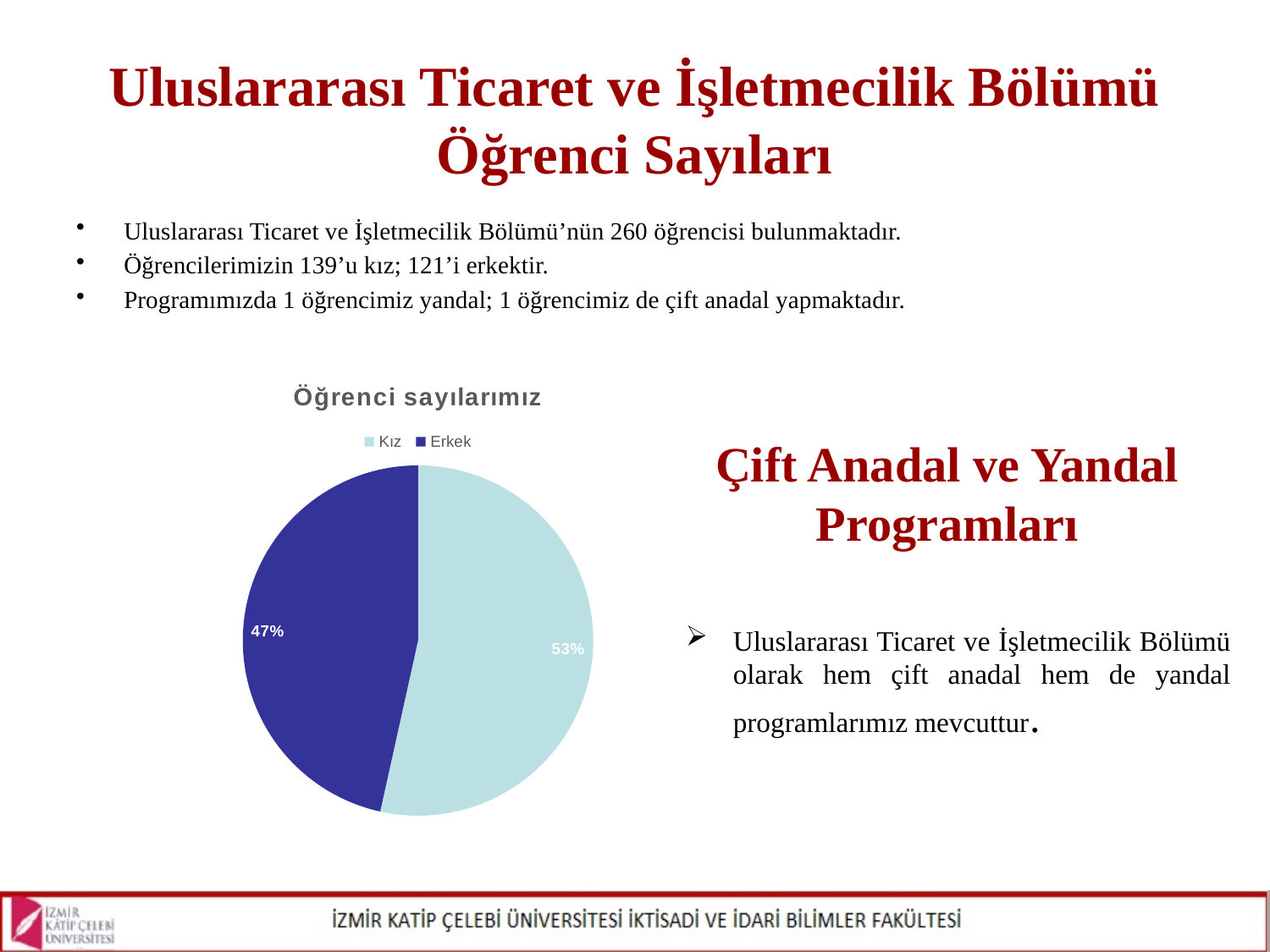
What share of the pie does the Kız slice represent? 53% What is the difference in percentage points between the Kız and Erkek slices? 6% What is the title of the chart? Öğrenci sayılarımız What share of the pie does the Erkek slice represent? 47% What kind of chart is shown on the slide? pie chart How many entries does the chart legend list? 2 Which is larger in the pie chart, Kız or Erkek? Kız How many slices does the pie chart have? 2 Which legend entry is shown in dark blue? Erkek Which slice of the pie chart is the smallest? Erkek Which slice of the pie chart is the largest? Kız